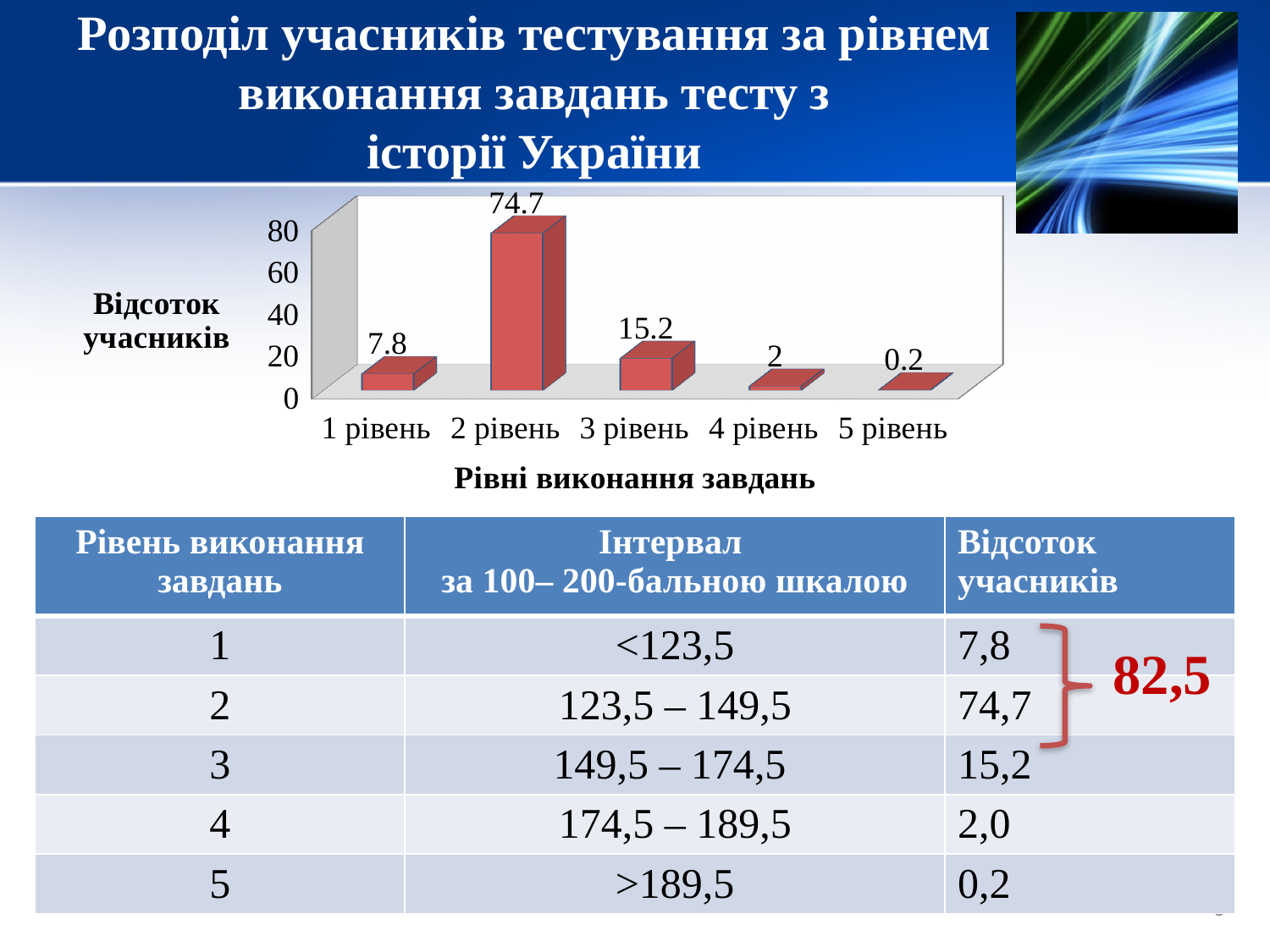
Which is larger, the value for 1 рівень or the value for 3 рівень? 3 рівень Is the value for 2 рівень greater or less than 60? greater What is the value for 2 рівень in the chart? 74.7 What is the value for 1 рівень in the chart? 7.8 What kind of chart is shown on the slide? bar chart Which category has the lowest value in the chart? 5 рівень Which category has the highest value in the chart? 2 рівень What is the difference between the values for 2 рівень and 3 рівень? 59.5 How many categories are shown on the x axis of the chart? 5 What is the value for 5 рівень in the chart? 0.2 What is the value for 4 рівень in the chart? 2 What is the title of the x axis of the chart? Рівні виконання завдань